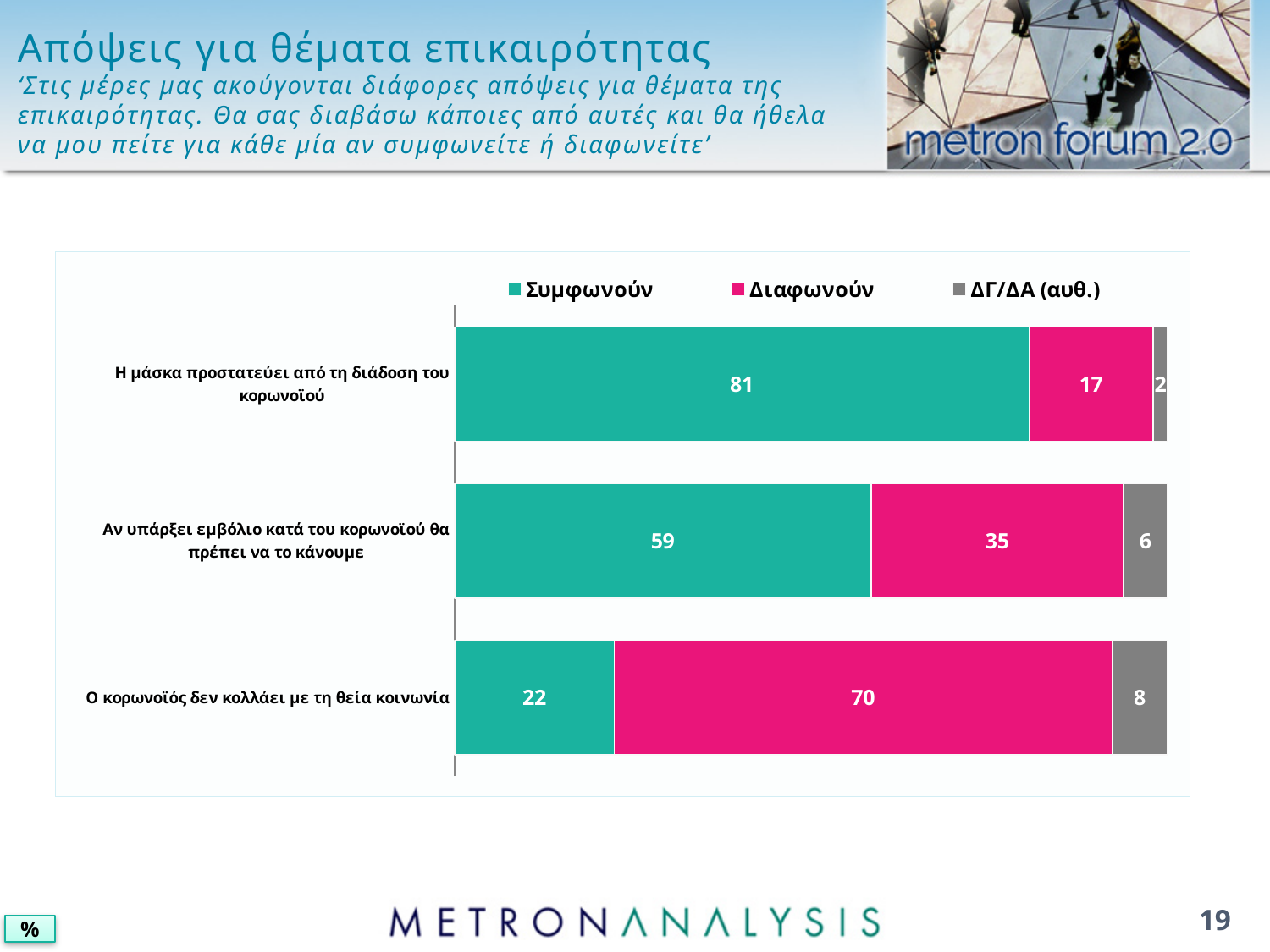
How many series does the legend list? 3 Which statement has the highest Συμφωνούν value? Η μάσκα προστατεύει από τη διάδοση του κορωνοϊού Which colour represents Διαφωνούν in the chart? Pink/magenta What percentage agree (Συμφωνούν) that the mask protects against the spread of the coronavirus (Η μάσκα προστατεύει από τη διάδοση του κορωνοϊού)? 81 Which is larger for the vaccine statement (Αν υπάρξει εμβόλιο κατά του κορωνοϊού θα πρέπει να το κάνουμε): Συμφωνούν or Διαφωνούν? Συμφωνούν What is the difference between the Συμφωνούν and Διαφωνούν values for the statement 'Ο κορωνοϊός δεν κολλάει με τη θεία κοινωνία'? 48 How many statements are shown in the chart? 3 What percentage disagree (Διαφωνούν) with the statement 'Αν υπάρξει εμβόλιο κατά του κορωνοϊού θα πρέπει να το κάνουμε'? 35 What is the ΔΓ/ΔΑ (αυθ.) value for the statement 'Ο κορωνοϊός δεν κολλάει με τη θεία κοινωνία'? 8 What kind of chart is shown on the slide? Stacked bar chart Which statement has the lowest Διαφωνούν value? Η μάσκα προστατεύει από τη διάδοση του κορωνοϊού What is the total of the stacked bar for the statement 'Αν υπάρξει εμβόλιο κατά του κορωνοϊού θα πρέπει να το κάνουμε'? 100